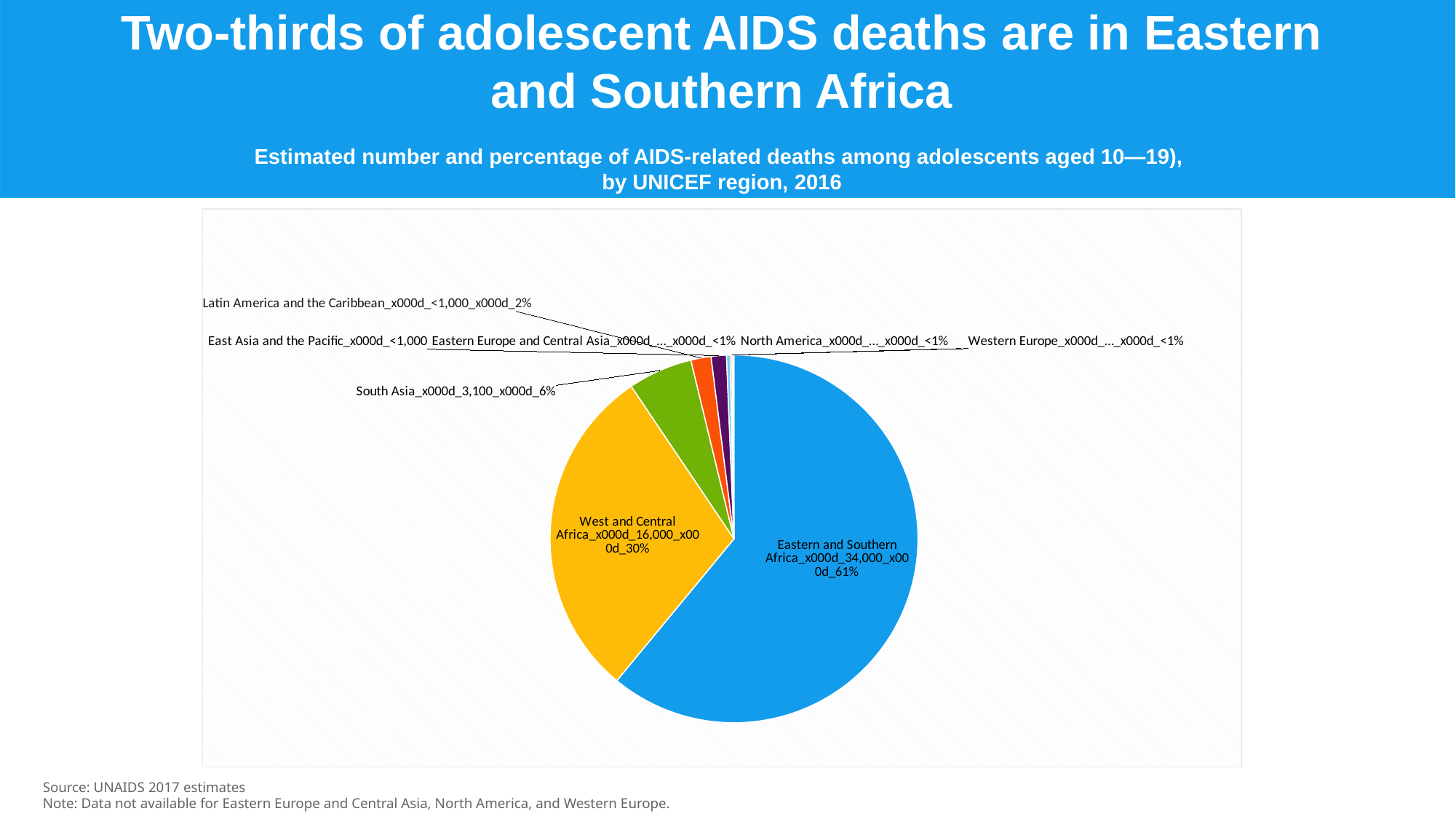
What is the difference in estimated adolescent AIDS-related deaths between Eastern and Southern Africa and West and Central Africa? 18,000 What is the estimated number of adolescent AIDS-related deaths in South Asia? 3,100 What is the estimated number of AIDS-related deaths among adolescents in Eastern and Southern Africa? 34,000 What share of the pie does West and Central Africa represent? 30% What percentage of adolescent AIDS-related deaths does Eastern and Southern Africa account for? 61% What kind of chart is shown on the slide? pie chart Which region has more adolescent AIDS-related deaths, South Asia or West and Central Africa? West and Central Africa What percentage of adolescent AIDS-related deaths is attributed to Latin America and the Caribbean? 2% What colour is the slice for West and Central Africa? yellow/orange Which region has the largest share of adolescent AIDS-related deaths in the pie chart? Eastern and Southern Africa What is the estimated number of AIDS-related deaths among adolescents in West and Central Africa? 16,000